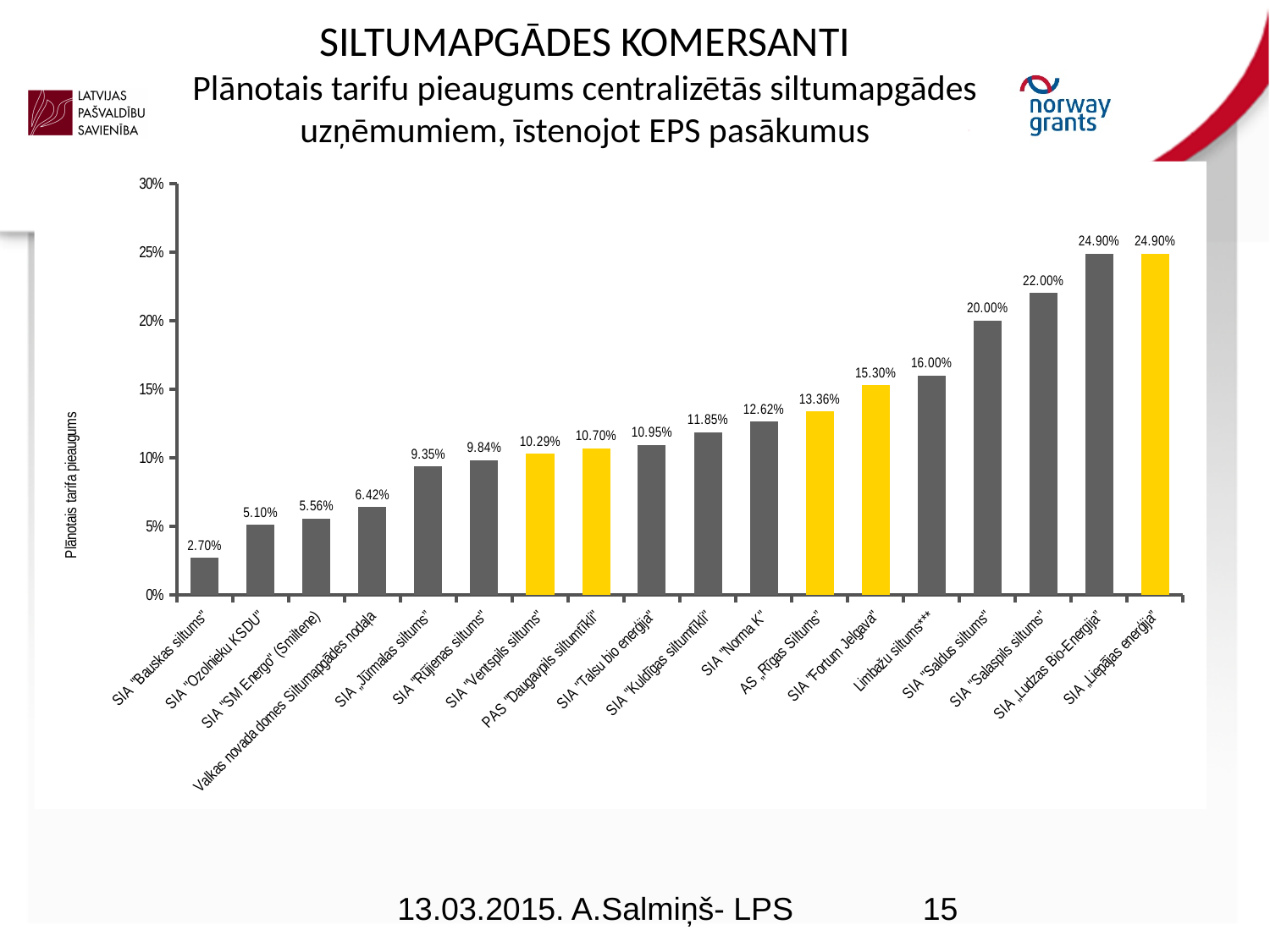
What is the planned tariff increase for SIA "Saldus siltums"? 20.00% How many companies are shown on the chart? 18 What type of chart is shown on the slide? Bar chart What is the difference between the planned tariff increases of SIA "Fortum Jelgava" and SIA "Bauskas siltums"? 12.60% What is the difference between the planned tariff increases of SIA "Salaspils siltums" and SIA "Saldus siltums"? 2.00% What is the planned tariff increase for SIA "Bauskas siltums"? 2.70% Which has a larger planned tariff increase, SIA "Norma K" or SIA "Kuldīgas siltumtīkli"? SIA "Norma K" Which company has the lowest planned tariff increase? SIA "Bauskas siltums" Is the value for Limbažu siltums*** greater or less than 15%? greater Do the values rise or fall from left to right along the x axis? Rise What is the planned tariff increase for AS "Rīgas Siltums"? 13.36% What is the planned tariff increase for SIA "Fortum Jelgava"? 15.30%